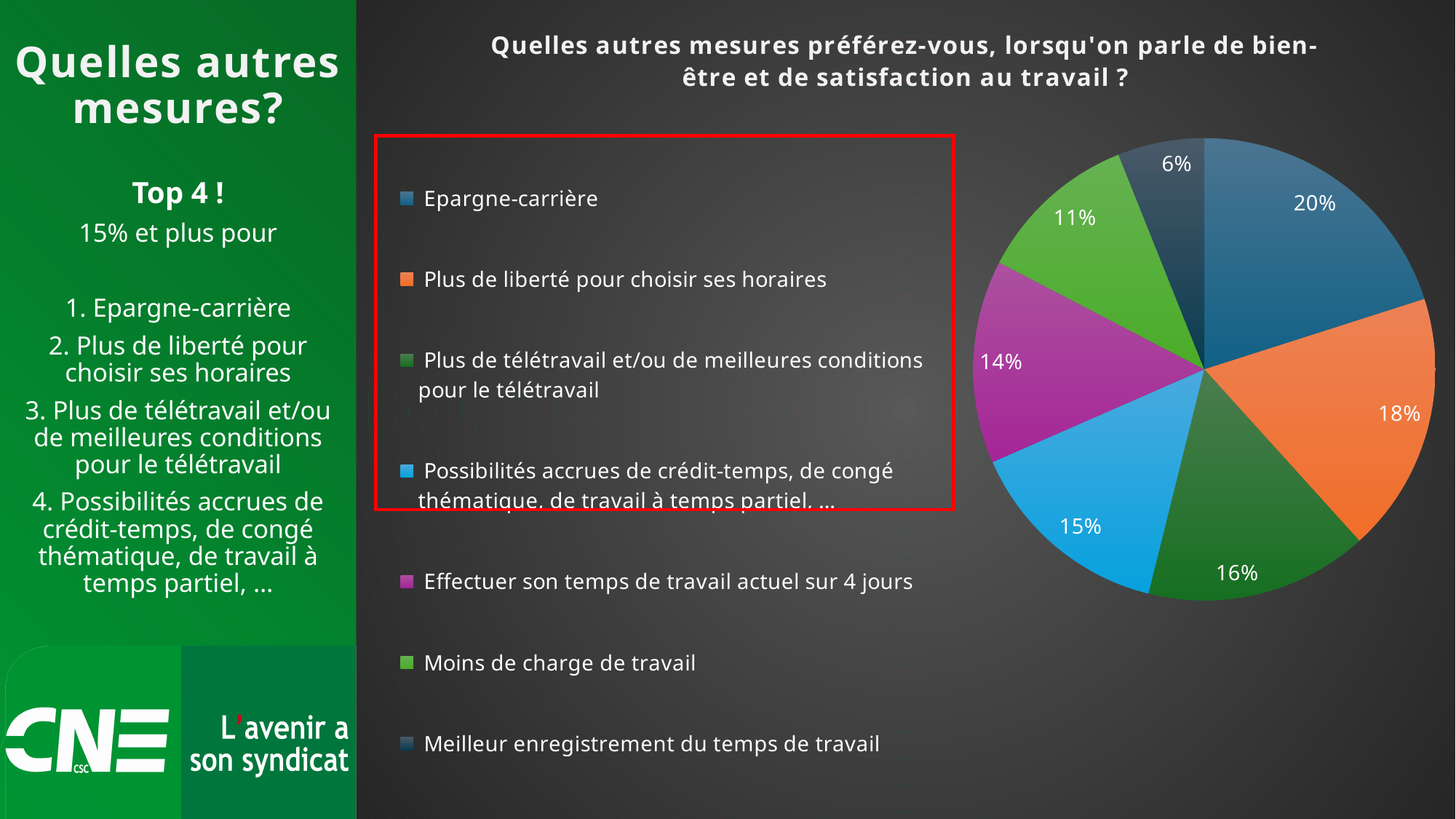
What is the value shown for Effectuer son temps de travail actuel sur 4 jours? 14% Which measure has the smallest slice of the pie? Meilleur enregistrement du temps de travail Which measure has the largest slice of the pie? Epargne-carrière What is the value shown for Meilleur enregistrement du temps de travail? 6% Which is larger: Possibilités accrues de crédit-temps or Effectuer son temps de travail actuel sur 4 jours? Possibilités accrues de crédit-temps What is the value shown for Plus de télétravail et/ou de meilleures conditions pour le télétravail? 16% What is the title of the chart? Quelles autres mesures préférez-vous, lorsqu'on parle de bien-être et de satisfaction au travail ? What is the difference in percentage points between Epargne-carrière and Moins de charge de travail? 9 What is the value shown for Plus de liberté pour choisir ses horaires? 18% What type of chart is shown on the slide? Pie chart How many slices does the pie chart have? 7 What share of the pie does Epargne-carrière represent? 20%